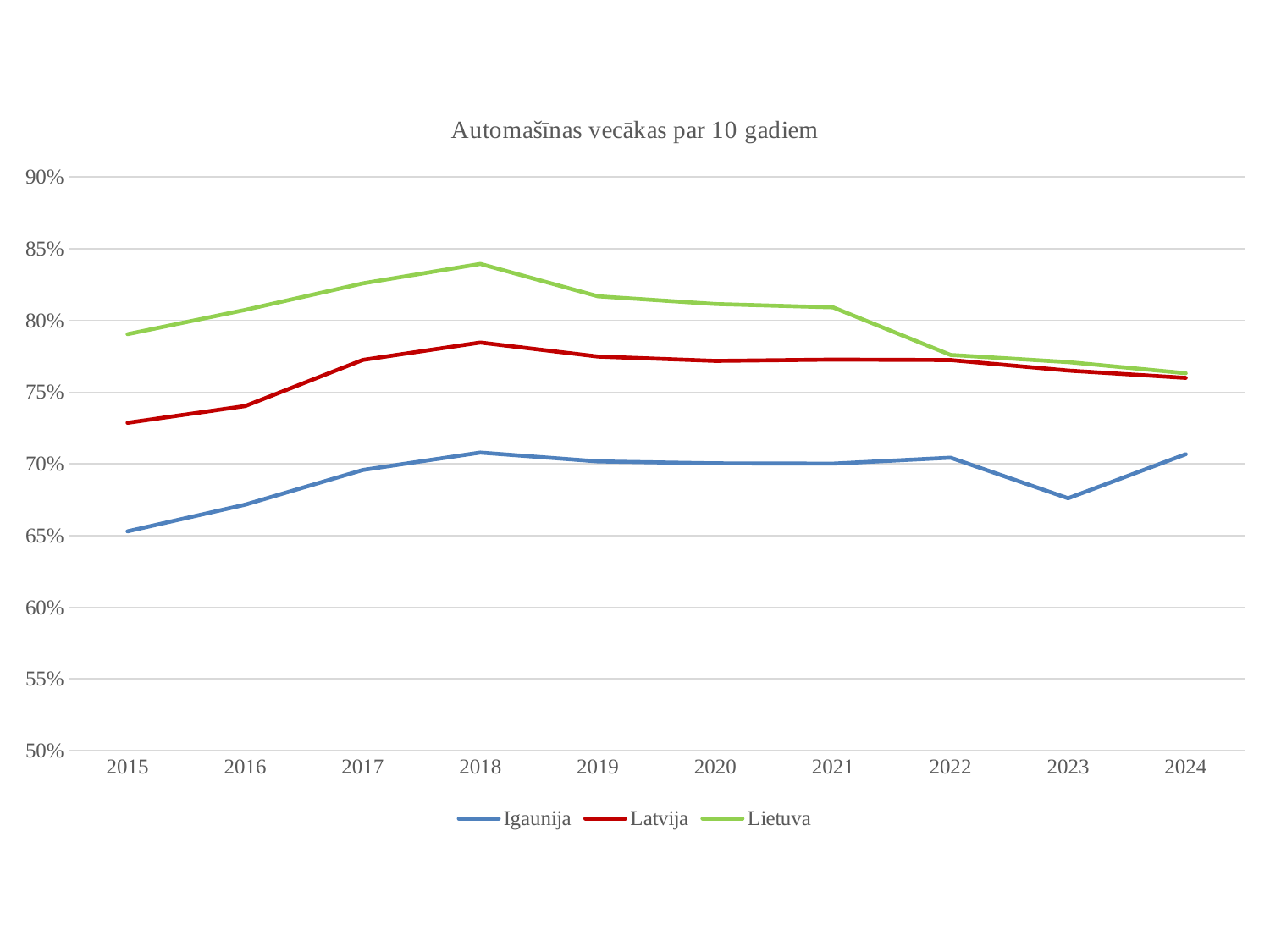
In which year does the Lietuva series reach its highest value? 2018 How many years are plotted along the x axis? 10 For Igaunija, which year has the larger value, 2023 or 2024? 2024 Which series has the lowest value in 2015? Igaunija Is the value for Lietuva in 2018 greater or less than 80%? greater Is the value for Latvija in 2024 greater or less than 75%? greater What is the title of the chart? Automašīnas vecākas par 10 gadiem What kind of chart is shown on the slide? line chart How many series does the legend list? 3 Which series has the highest value in 2018? Lietuva Do the values for Lietuva rise or fall from 2018 to 2024? fall Is the value for Igaunija in 2015 greater or less than 70%? less